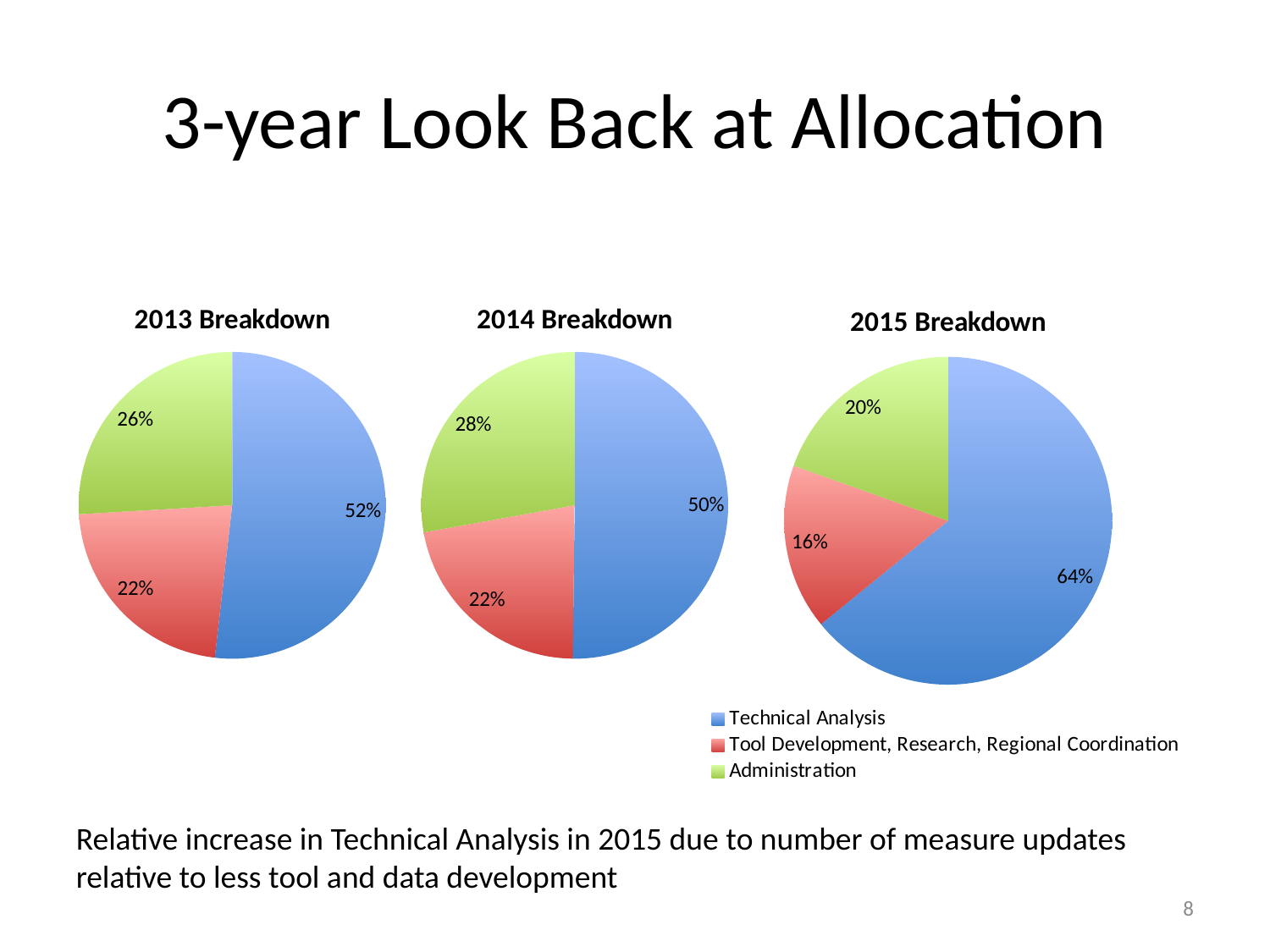
In the 2014 Breakdown chart, what share does Administration have? 28% In the 2015 Breakdown chart, which category has the largest slice? Technical Analysis In the 2013 Breakdown chart, what share does Technical Analysis have? 52% What colour represents Administration in the charts? Green In the 2015 Breakdown chart, what share does Tool Development, Research, Regional Coordination have? 16% Across the three charts, does the Technical Analysis share rise or fall from 2014 to 2015? Rise In the 2015 Breakdown chart, what is the difference between the Technical Analysis share and the Administration share? 44% How many slices does the 2014 Breakdown pie chart have? 3 In the 2013 Breakdown chart, which category has the smallest slice? Tool Development, Research, Regional Coordination In the 2014 Breakdown chart, which is larger: Administration or Tool Development, Research, Regional Coordination? Administration How many entries does the legend list? 3 What kind of chart is the 2013 Breakdown chart? Pie chart